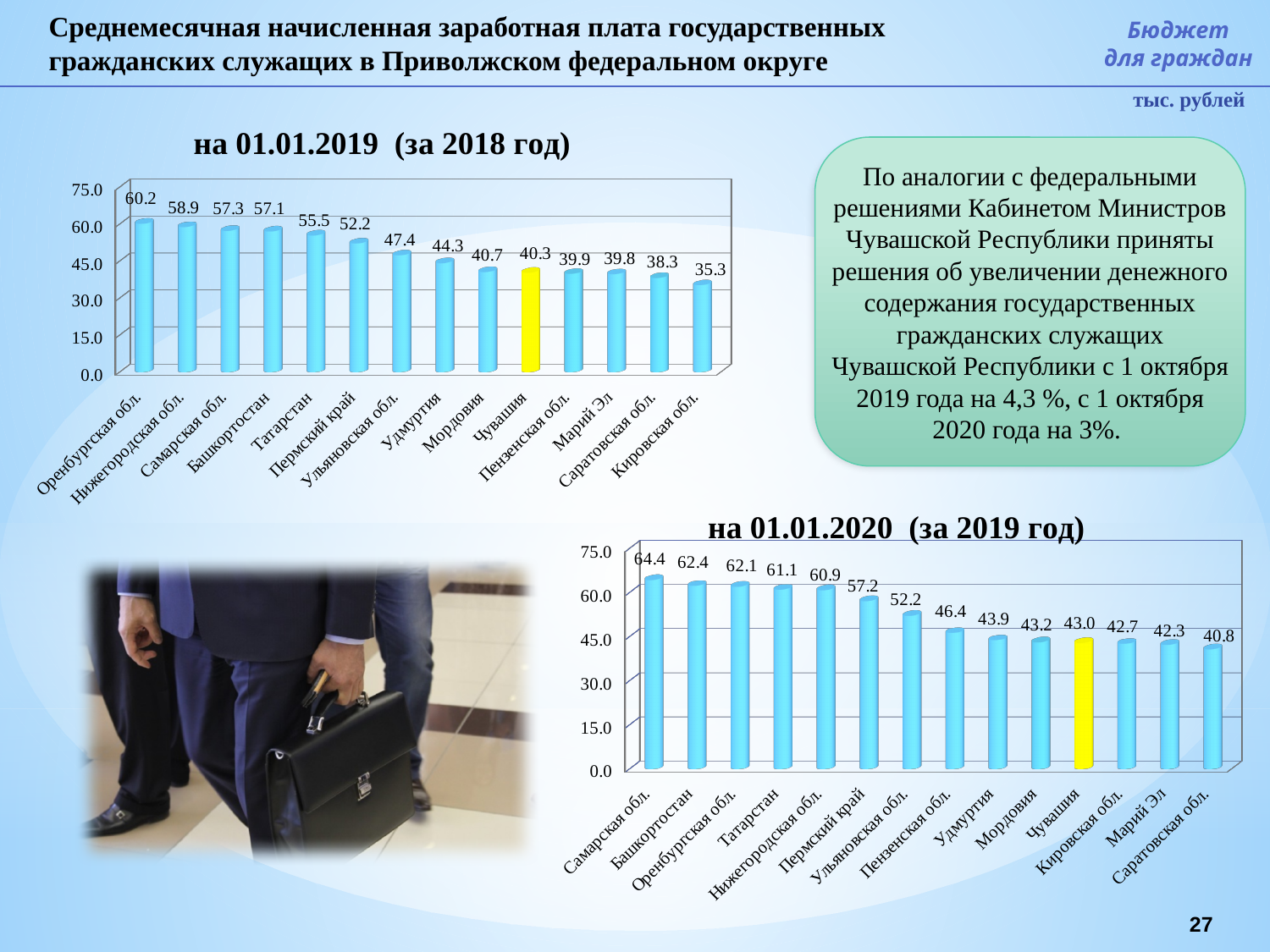
What kind of chart is 'на 01.01.2019 (за 2018 год)'? Bar chart In the chart 'на 01.01.2020 (за 2019 год)', what is the value for Самарская обл.? 64.4 In the chart 'на 01.01.2019 (за 2018 год)', what is the value for Чувашия? 40.3 In the chart 'на 01.01.2020 (за 2019 год)', what is the value for Пензенская обл.? 46.4 In the chart 'на 01.01.2020 (за 2019 год)', which region has the lowest value? Саратовская обл. In the chart 'на 01.01.2020 (за 2019 год)', which is larger: the value for Пермский край or the value for Ульяновская обл.? Пермский край How many regions are shown in the chart 'на 01.01.2020 (за 2019 год)'? 14 In the chart 'на 01.01.2020 (за 2019 год)', do the values rise or fall from left to right? Fall In the chart 'на 01.01.2019 (за 2018 год)', which region has the highest value? Оренбургская обл. In the chart 'на 01.01.2019 (за 2018 год)', is the value for Татарстан greater or less than 45.0? greater In the chart 'на 01.01.2020 (за 2019 год)', which bar is highlighted in yellow? Чувашия In the chart 'на 01.01.2019 (за 2018 год)', what is the difference between the values for Оренбургская обл. and Кировская обл.? 24.9